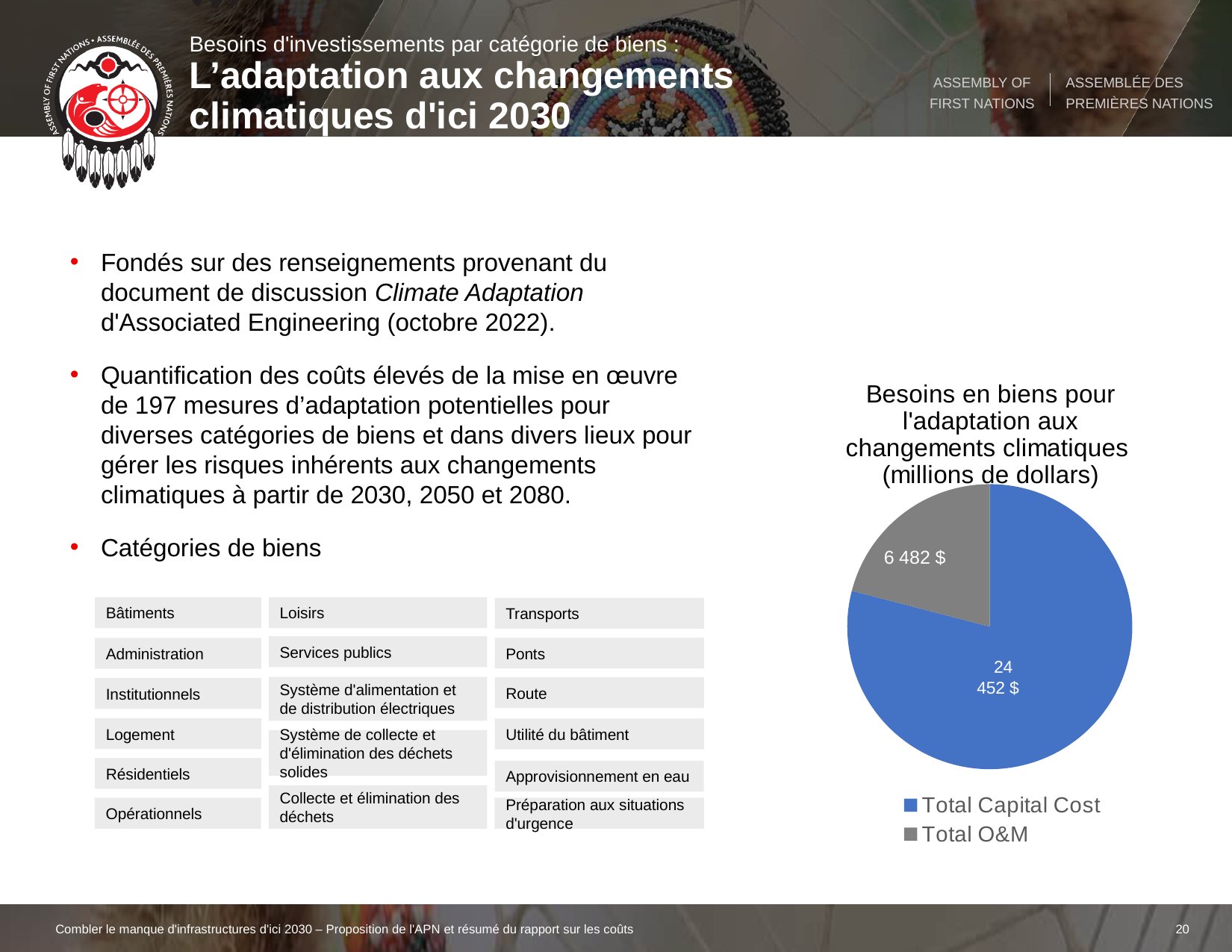
What is the value for Total O&M in the pie chart? 6 482 $ What is the value for Total Capital Cost in the pie chart? 24 452 $ How many slices does the pie chart have? 2 In what unit are the values of the pie chart expressed, according to its title? millions de dollars Which is larger, Total Capital Cost or Total O&M? Total Capital Cost What is the difference between Total Capital Cost and Total O&M? 17 970 $ What is the total of the two slices in the pie chart? 30 934 $ Which slice of the pie chart is the smallest? Total O&M How many entries does the legend of the pie chart list? 2 Which slice of the pie chart is the largest? Total Capital Cost What kind of chart is shown on the slide? pie chart